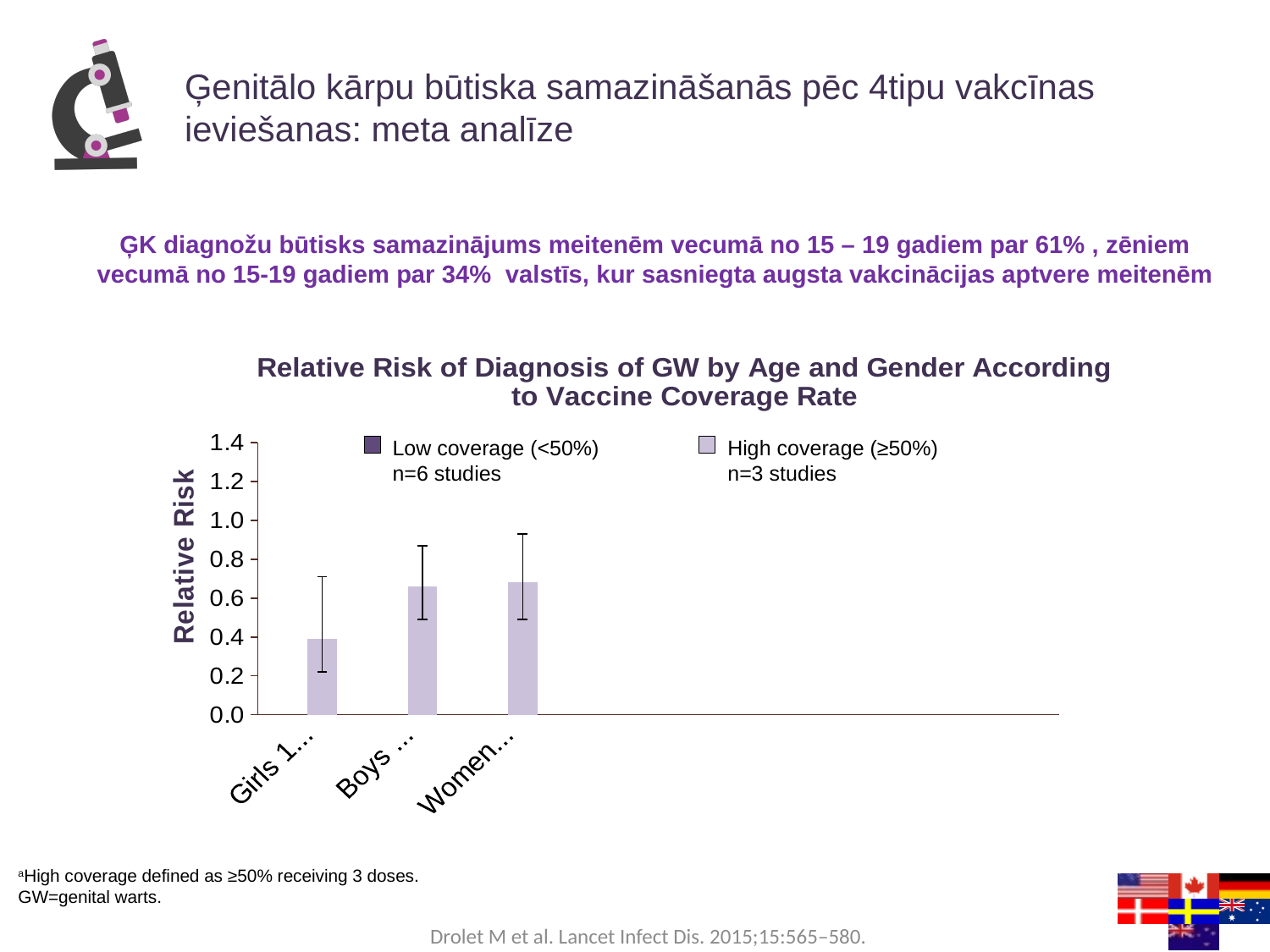
What is the title of the y axis of the chart? Relative Risk How many series does the chart legend list? 2 How many bars are plotted in the chart? 3 Is the relative risk value for Girls greater or less than 0.6? less Which category has the lowest relative risk in the chart? Girls Which has a larger relative risk, Girls or Boys? Boys What is the title of the chart? Relative Risk of Diagnosis of GW by Age and Gender According to Vaccine Coverage Rate Is the relative risk value for Boys greater or less than 0.8? less Is the relative risk value for Women greater or less than 1.0? less What kind of chart is shown on the slide? bar chart Do the bar values rise or fall from left to right along the x axis? rise